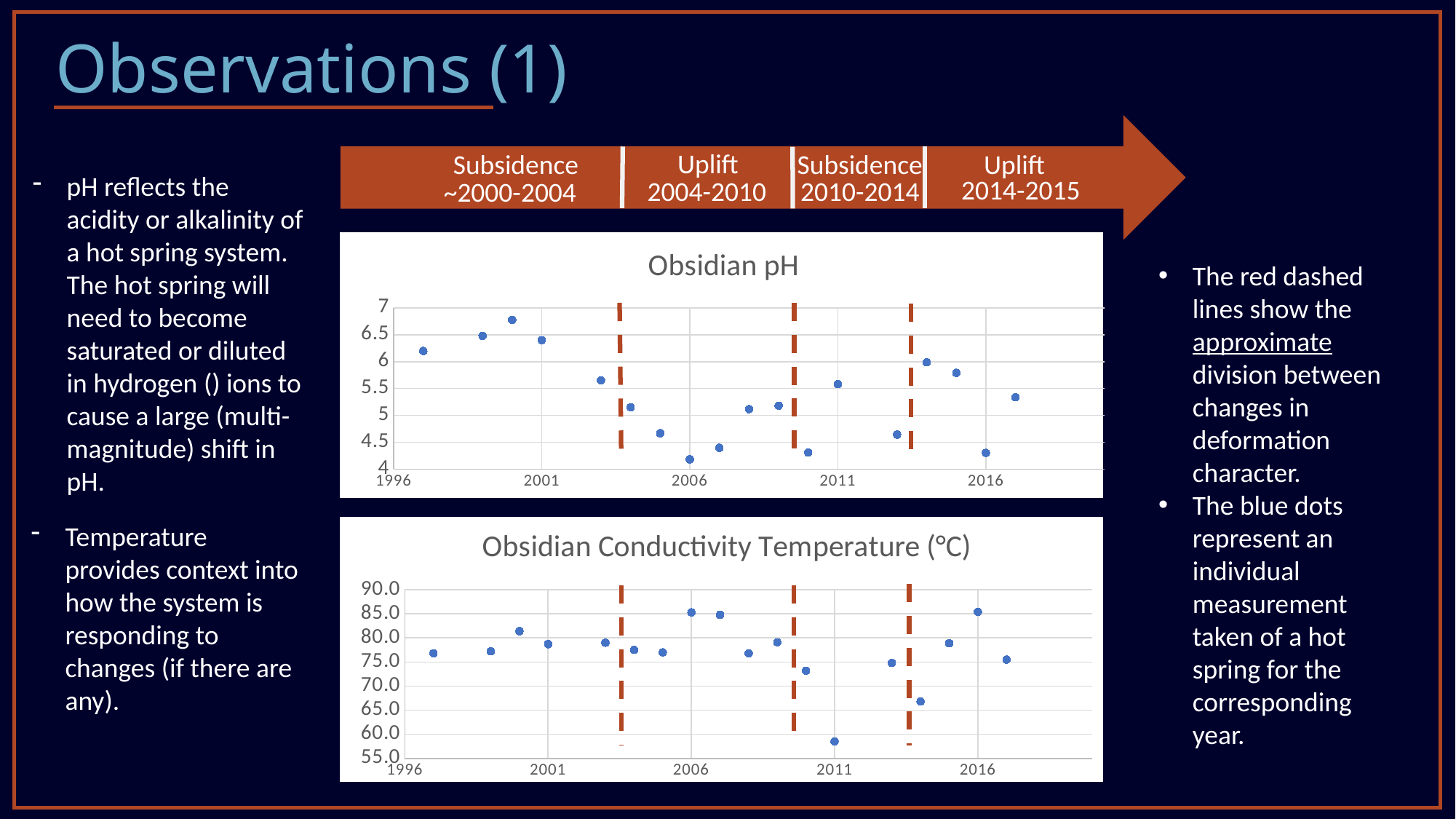
In the Obsidian pH chart, how many red dashed vertical lines are drawn? 3 In the Obsidian pH chart, is the pH value for the point at 2006 greater or less than 4.5? less In the Obsidian pH chart, do the pH values rise or fall between 2001 and 2006? fall In the Obsidian pH chart, is the pH value for the point near 2000 greater or less than 6.5? greater In the Obsidian Conductivity Temperature chart, is the value for the point near 2014 greater or less than 70.0? less In the Obsidian pH chart, around which year does the highest pH value occur? 2000 What is the title of the lower chart on the slide? Obsidian Conductivity Temperature (°C) In the Obsidian Conductivity Temperature chart, around which year does the lowest temperature occur? 2011 In the Obsidian pH chart, which point has the higher pH: the one at 1997 or the one at 2006? 1997 What kind of chart is the Obsidian pH chart? scatter chart What kind of chart is the Obsidian Conductivity Temperature chart? scatter chart